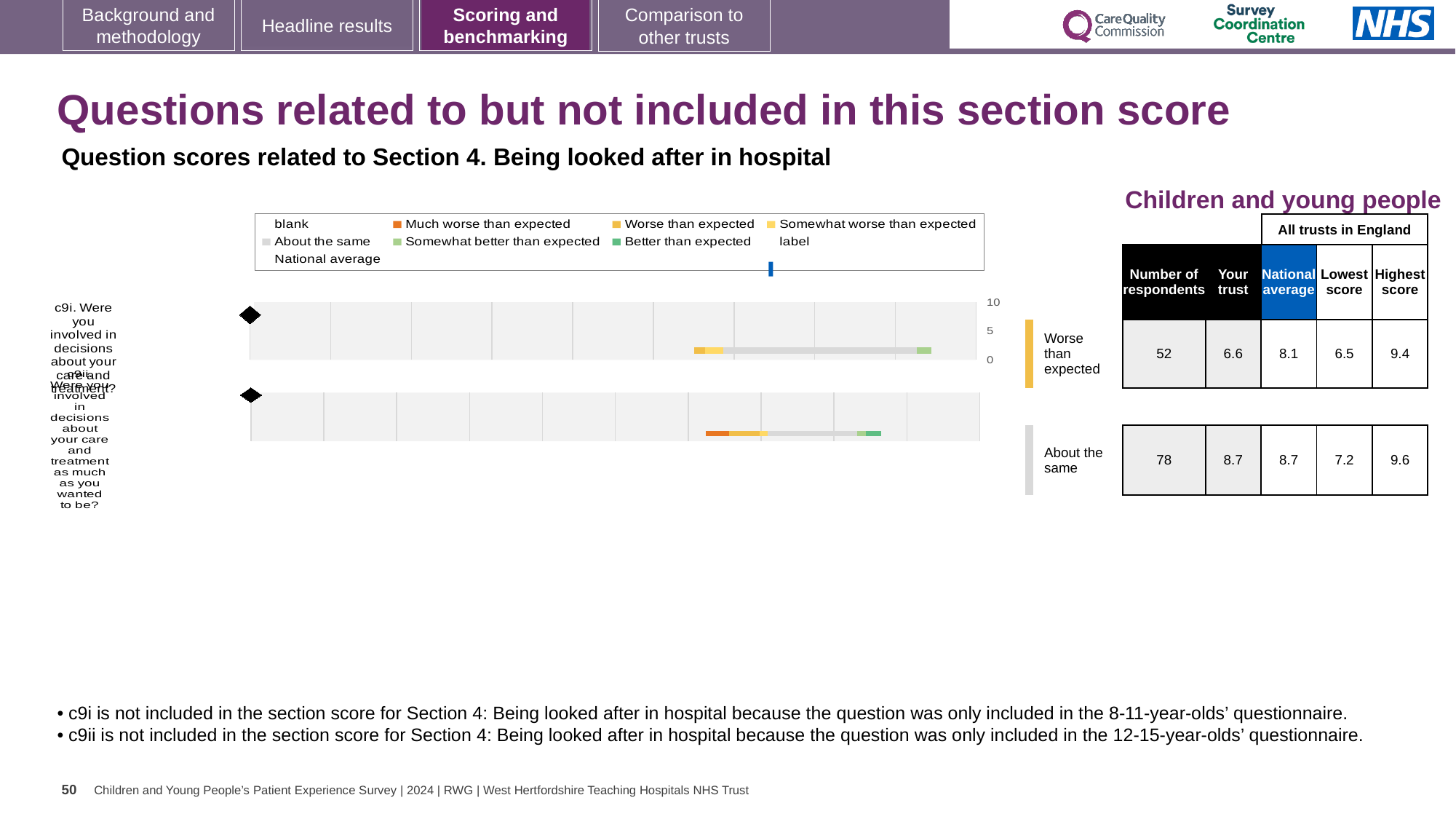
In the table beside the chart, what is the 'Your trust' score for c9i (Worse than expected)? 6.6 What kind of chart is used to show the question scores related to Section 4? bar chart In the table beside the chart, what is the difference between the national average and the trust score for c9i (Worse than expected)? 1.5 Which benchmark category is shown for question c9i? Worse than expected In the table beside the chart, what is the highest score across all trusts in England for c9ii (About the same)? 9.6 In the table beside the chart, what is the national average for c9ii (About the same)? 8.7 In the table beside the chart, which question has the higher 'Your trust' score, c9i or c9ii? c9ii In the table beside the chart, how many respondents answered c9i (Worse than expected)? 52 In the table beside the chart, what is the difference between the highest and lowest scores for c9ii (About the same)? 2.4 What is the subtitle of the chart on this slide? Question scores related to Section 4. Being looked after in hospital Which benchmark category is shown for question c9ii? About the same How many questions (bars) are plotted in the chart? 2